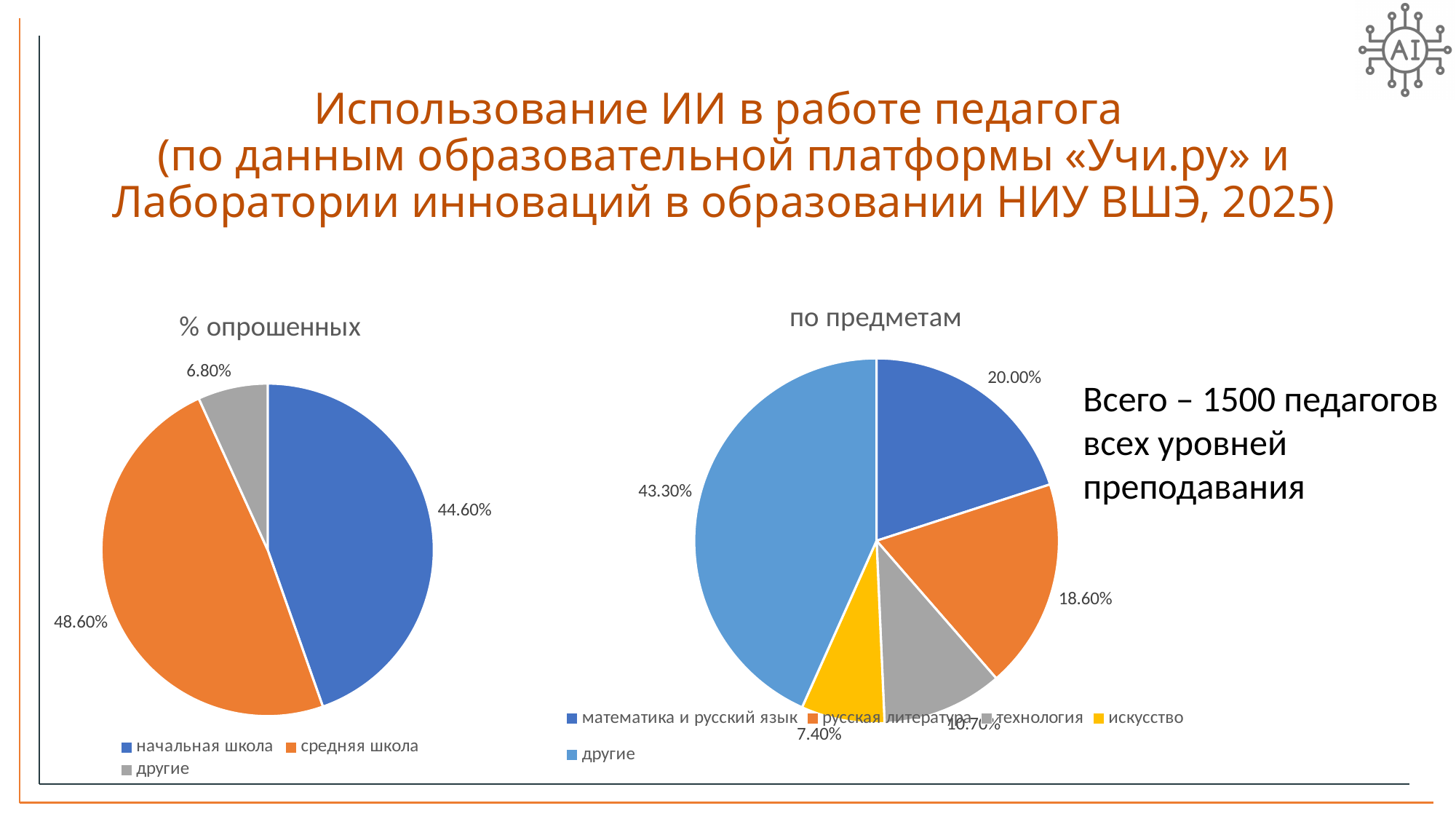
In the 'по предметам' chart, what colour is the 'искусство' slice? yellow How many categories does the '% опрошенных' chart show? 3 In the 'по предметам' chart, which is larger: 'математика и русский язык' or 'русская литература'? математика и русский язык In the '% опрошенных' chart, what is the value for 'начальная школа'? 44.60% In the '% опрошенных' chart, which category has the smallest share? другие In the 'по предметам' chart, which category has the largest share? другие How many categories does the legend of the 'по предметам' chart list? 5 In the 'по предметам' chart, what is the value for 'русская литература'? 18.60% What kind of chart is the '% опрошенных' chart? pie chart In the 'по предметам' chart, what is the value for 'искусство'? 7.40% In the '% опрошенных' chart, what is the value for 'средняя школа'? 48.60% In the '% опрошенных' chart, what is the difference between 'средняя школа' and 'начальная школа'? 4.00%